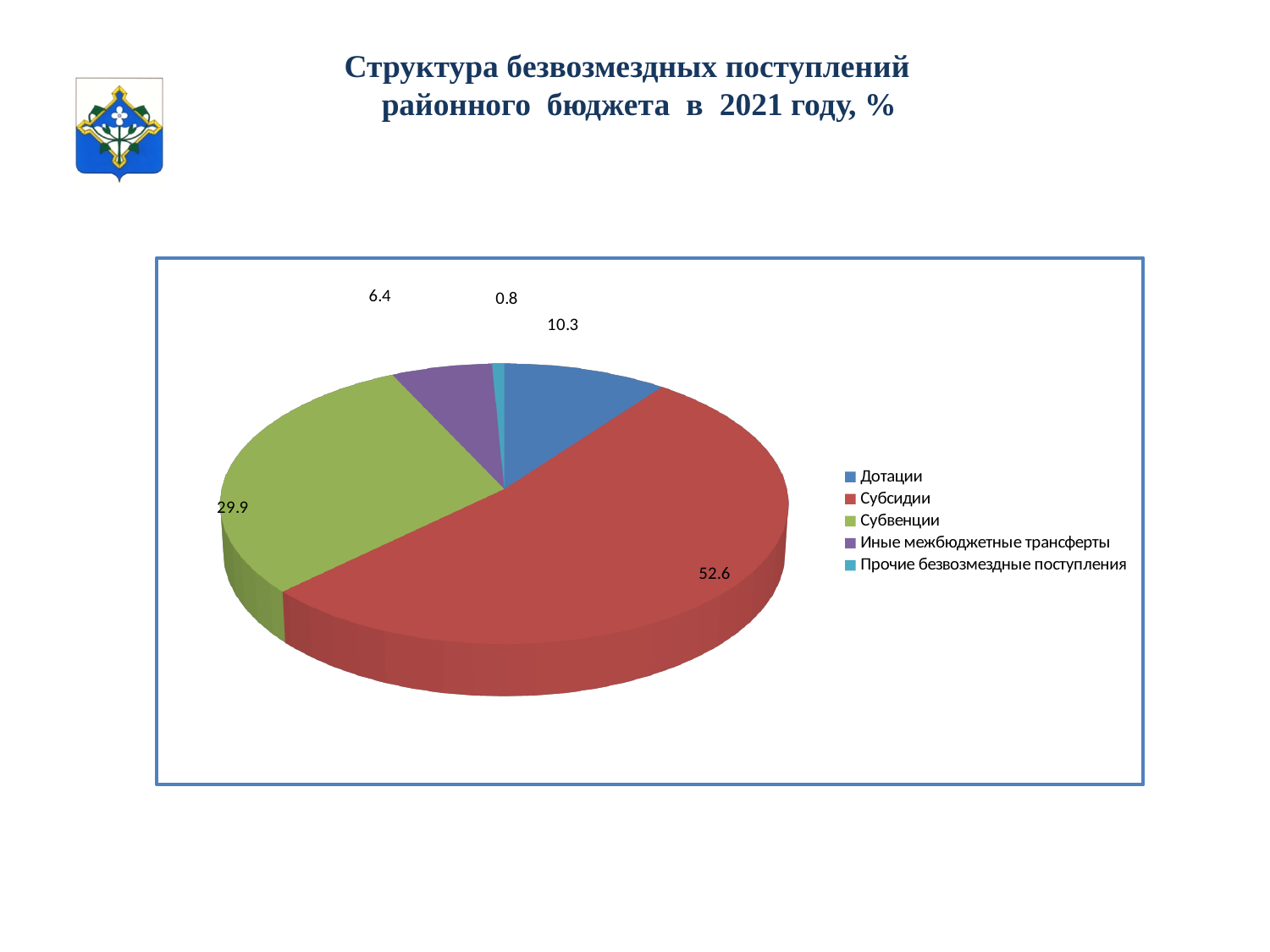
Which category has the smallest share of the pie? Прочие безвозмездные поступления What is the difference between the values for Субсидии and Субвенции? 22.7 How many categories does the legend list? 5 Which category has the largest share of the pie? Субсидии Which is larger, the value for Дотации or the value for Иные межбюджетные трансферты? Дотации What is the value for Дотации? 10.3 What type of chart is shown on the slide? Pie chart What is the value for Субсидии? 52.6 What colour is the slice for Субвенции? Green What is the value for Иные межбюджетные трансферты? 6.4 What is the value for Субвенции? 29.9 What is the value for Прочие безвозмездные поступления? 0.8